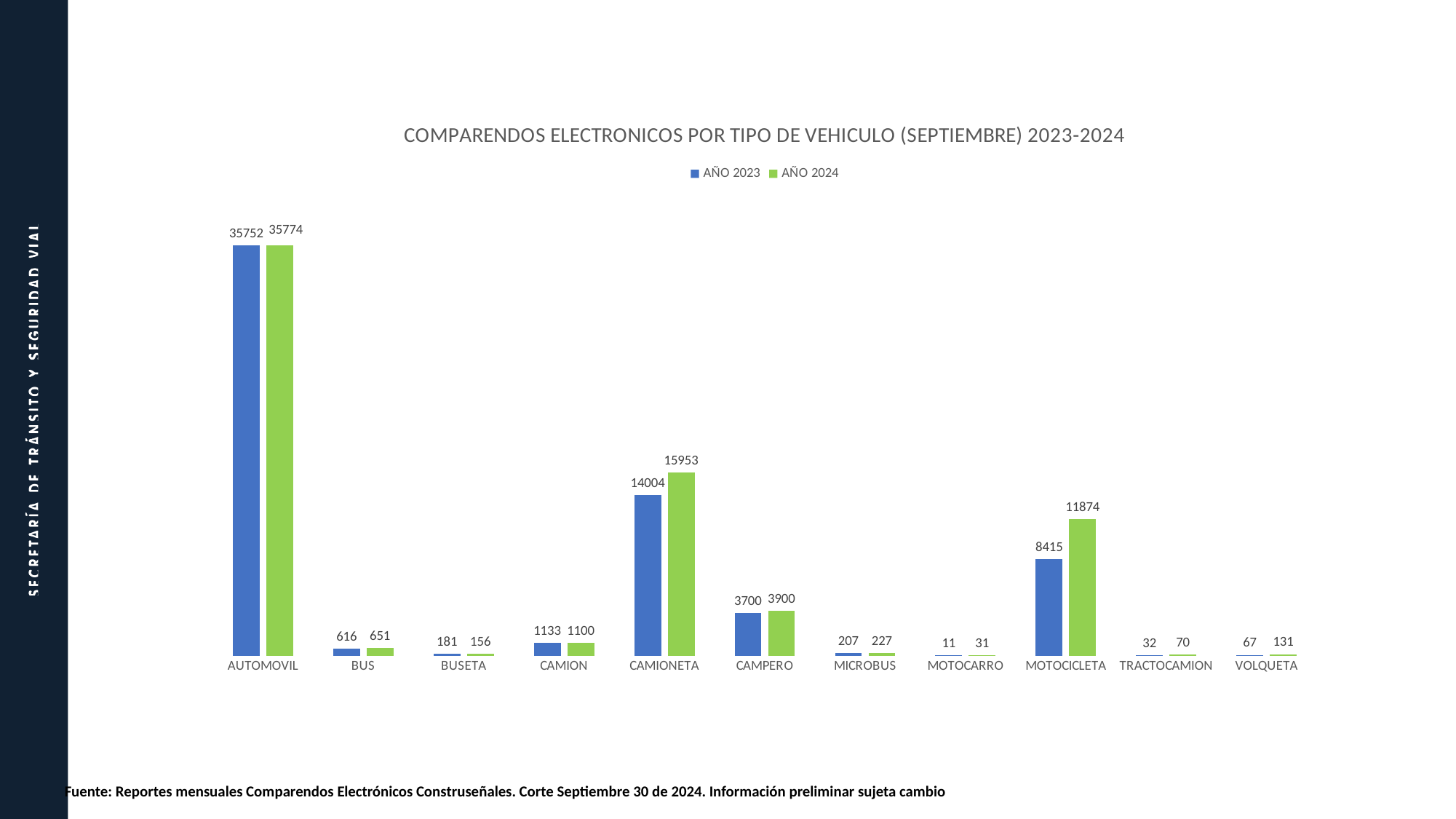
Which category has the lowest value in the AÑO 2023 series? MOTOCARRO What is the difference between the AÑO 2024 and AÑO 2023 values for CAMIONETA? 1949 Which category has the highest value in the AÑO 2024 series? AUTOMOVIL How many vehicle categories are shown on the x axis? 11 What is the difference between the AÑO 2024 and AÑO 2023 values for MOTOCICLETA? 3459 What is the title of the chart? COMPARENDOS ELECTRONICOS POR TIPO DE VEHICULO (SEPTIEMBRE) 2023-2024 What is the value for CAMIONETA in the AÑO 2023 series? 14004 What is the value for AUTOMOVIL in the AÑO 2023 series? 35752 How many series does the legend list? 2 For CAMION, which series has the larger value, AÑO 2023 or AÑO 2024? AÑO 2023 What kind of chart is shown on the slide? Bar chart What is the value for MOTOCICLETA in the AÑO 2024 series? 11874